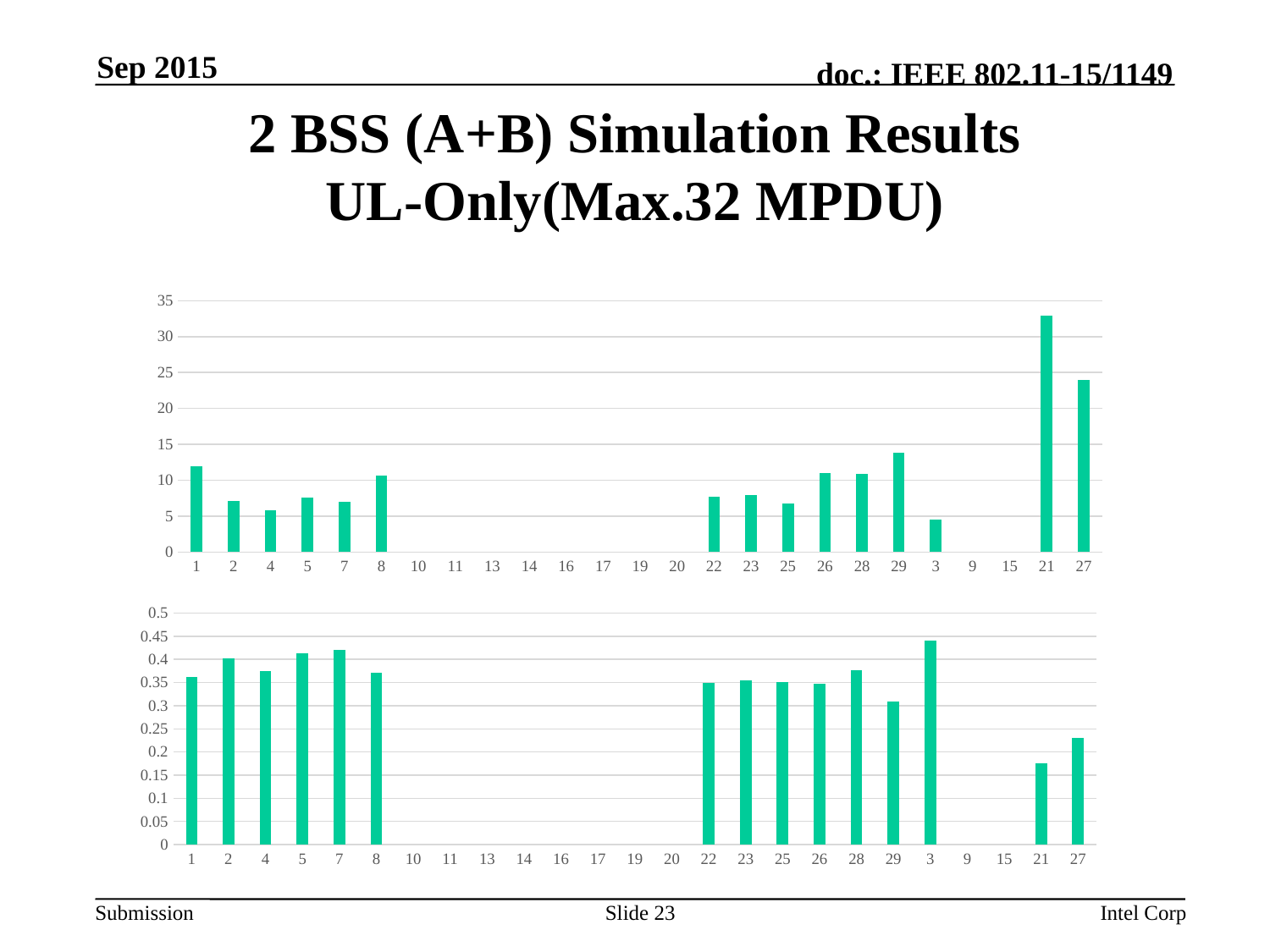
How many categories are listed along the x axis of the top chart? 25 In the top chart, is the value for category 27 greater or less than 20? greater In the bottom chart, is the value for category 21 greater or less than 0.2? less In the top chart, which has the larger value, category 1 or category 2? 1 What kind of chart is the bottom chart? bar chart In the bottom chart, is the value for category 27 greater or less than 0.2? greater In the top chart, which category has the tallest bar? 21 In the bottom chart, which category has the tallest bar? 3 In the bottom chart, which has the larger value, category 28 or category 29? 28